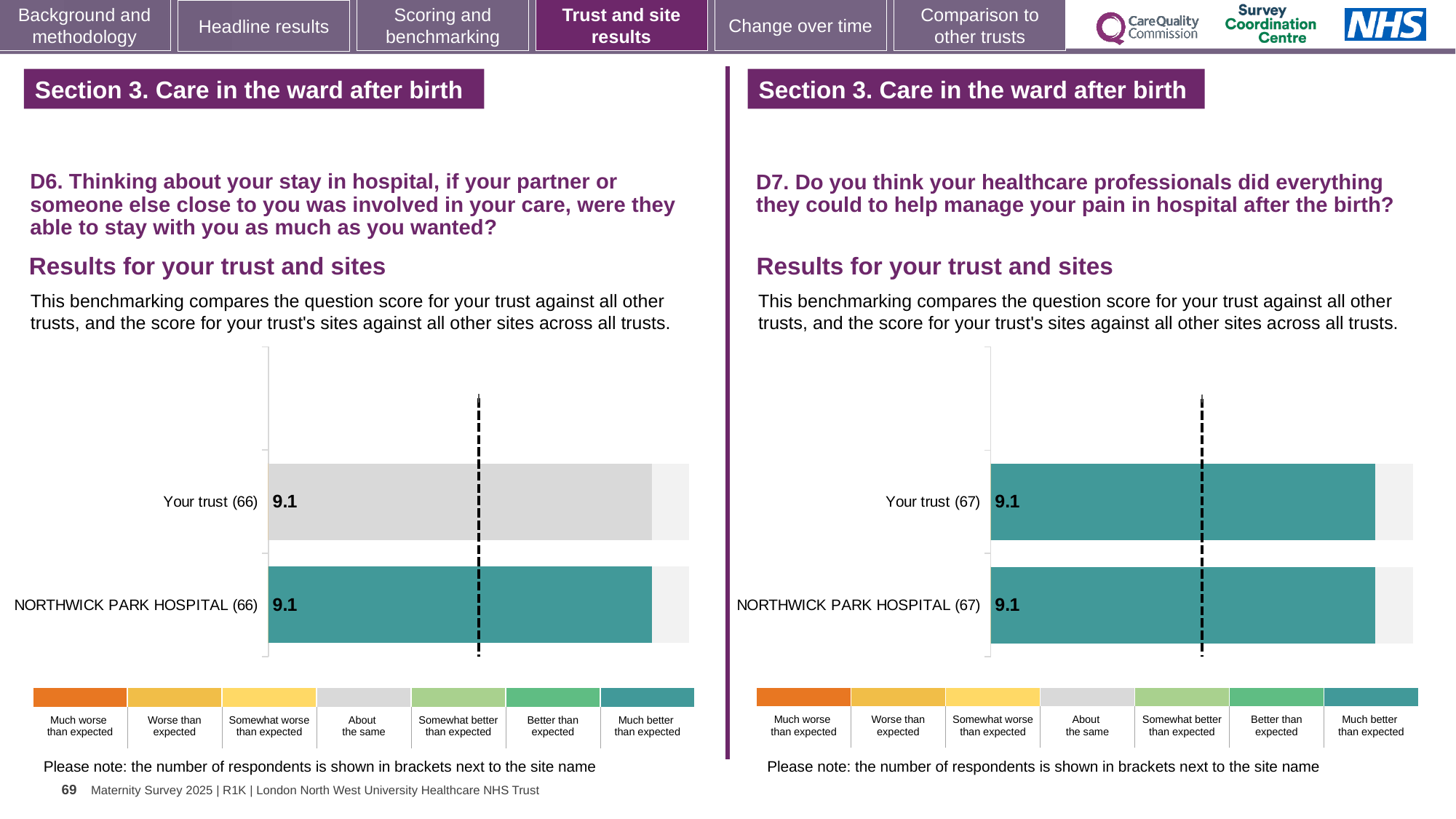
In the D7 chart on the right, how many respondents are shown in brackets next to NORTHWICK PARK HOSPITAL? 67 What kind of chart is the D6 chart on the left? Bar chart In the D7 chart on the right, which benchmark category does the teal colour of the bars represent according to the key? Much better than expected In the D6 chart on the left, what is the score for NORTHWICK PARK HOSPITAL? 9.1 In the D6 chart on the left, which benchmark category does the grey colour of the Your trust bar represent according to the key? About the same In the D6 chart on the left, how many respondents are shown in brackets next to Your trust? 66 In the D6 chart on the left, what is the difference between the score for Your trust and the score for NORTHWICK PARK HOSPITAL? 0 In the D7 chart on the right, what is the score for NORTHWICK PARK HOSPITAL? 9.1 In the D6 chart on the left, how many bars are plotted? 2 In the D7 chart on the right, what is the score for Your trust? 9.1 In the D6 chart on the left, what is the score for Your trust? 9.1 In the D7 chart on the right, how many bars are plotted? 2